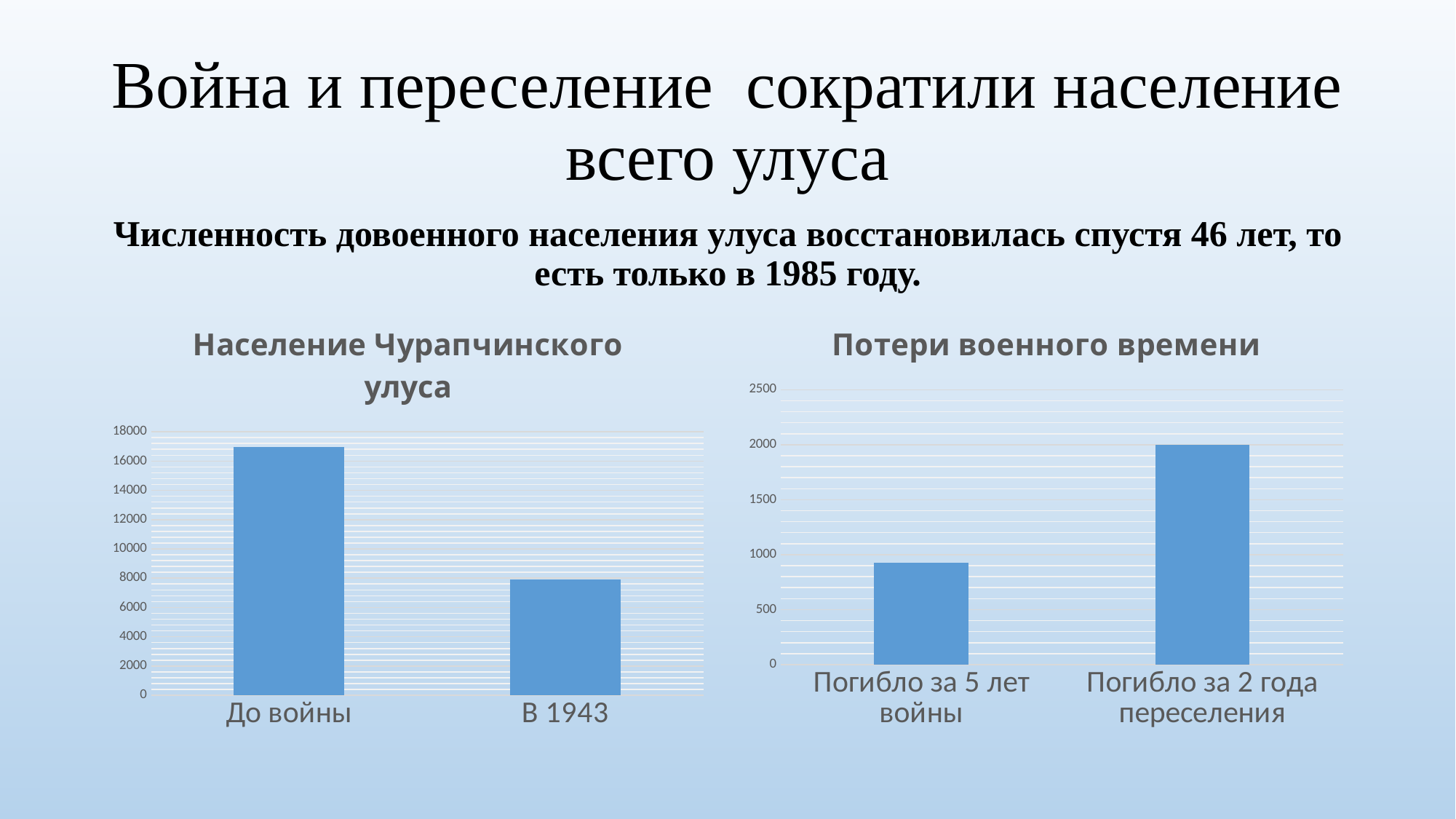
What kind of chart is the right chart, 'Потери военного времени'? bar chart What is the title of the right chart on the slide? Потери военного времени In the left chart 'Население Чурапчинского улуса', which category has the highest value? До войны In the left chart 'Население Чурапчинского улуса', which category has the lowest value? В 1943 What kind of chart is the left chart, 'Население Чурапчинского улуса'? bar chart In the right chart 'Потери военного времени', which is larger: 'Погибло за 5 лет войны' or 'Погибло за 2 года переселения'? Погибло за 2 года переселения In the right chart 'Потери военного времени', how many categories are shown? 2 In the left chart 'Население Чурапчинского улуса', is the value for 'В 1943' greater or less than 10000? less In the right chart 'Потери военного времени', which category has the highest value? Погибло за 2 года переселения In the left chart 'Население Чурапчинского улуса', is the value for 'До войны' greater or less than 16000? greater In the left chart 'Население Чурапчинского улуса', how many categories are shown? 2 In the right chart 'Потери военного времени', is the value for 'Погибло за 5 лет войны' greater or less than 1000? less